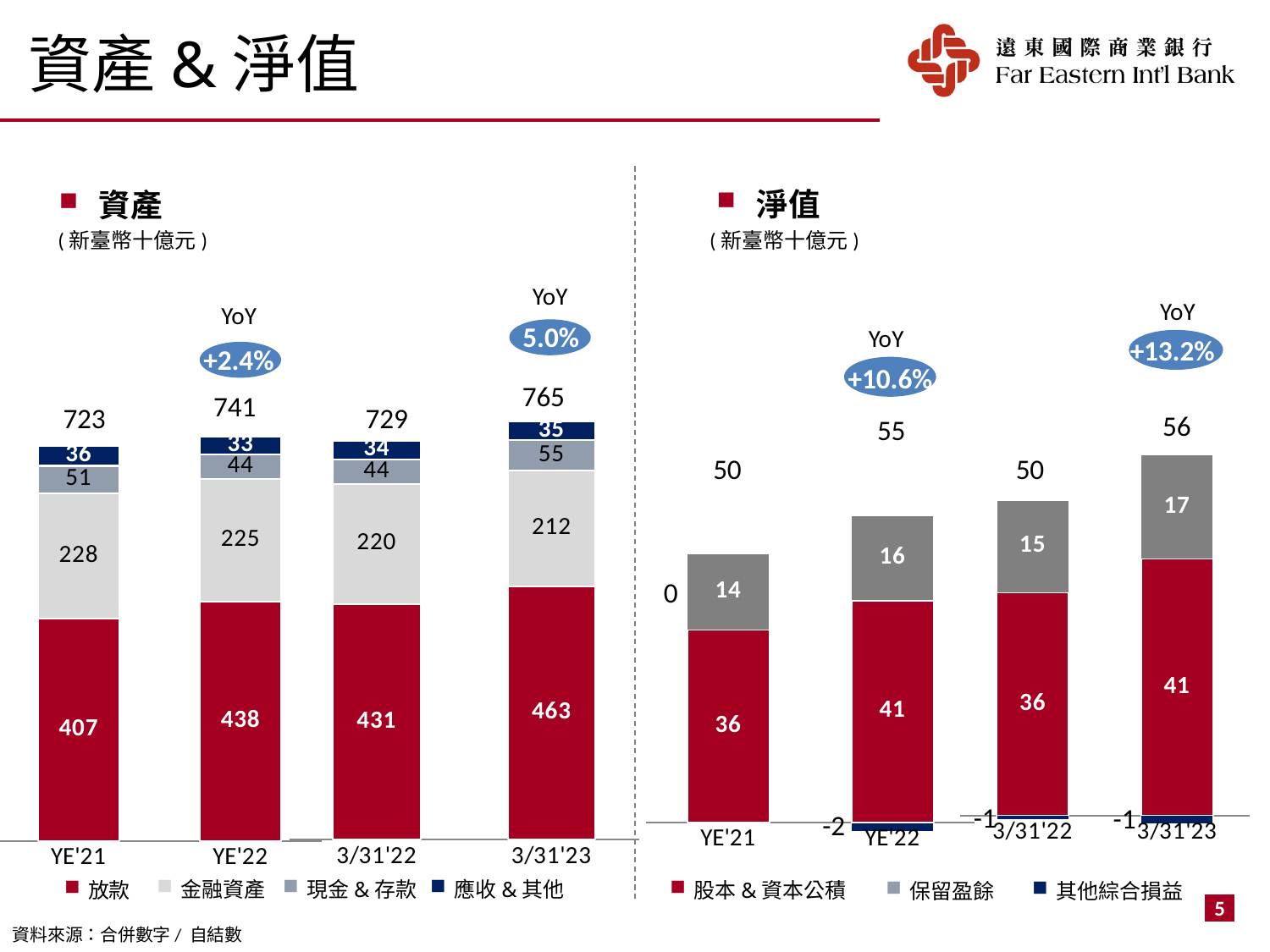
In the 淨值 chart, what is the 其他綜合損益 value for YE'22? -2 In the 淨值 chart, how many periods are plotted on the x axis? 4 In the 資產 chart, what YoY change is shown for 3/31'23? 5.0% In the 資產 chart, what is the total shown above the YE'22 bar? 741 In the 資產 chart, which period has the highest total assets? 3/31'23 In the 淨值 chart, is the 股本 & 資本公積 value larger for YE'22 or 3/31'22? YE'22 In the 淨值 chart, which period has the lowest total net worth? YE'21 and 3/31'22 (both 50) In the 資產 chart, what is the 放款 value for 3/31'23? 463 In the 資產 chart, what is the difference between the 金融資產 values for YE'21 and 3/31'23? 16 In the 淨值 chart, what is the 保留盈餘 value for 3/31'23? 17 What type of chart is the 淨值 chart? Stacked bar chart In the 資產 chart, how many series does the legend list? 4